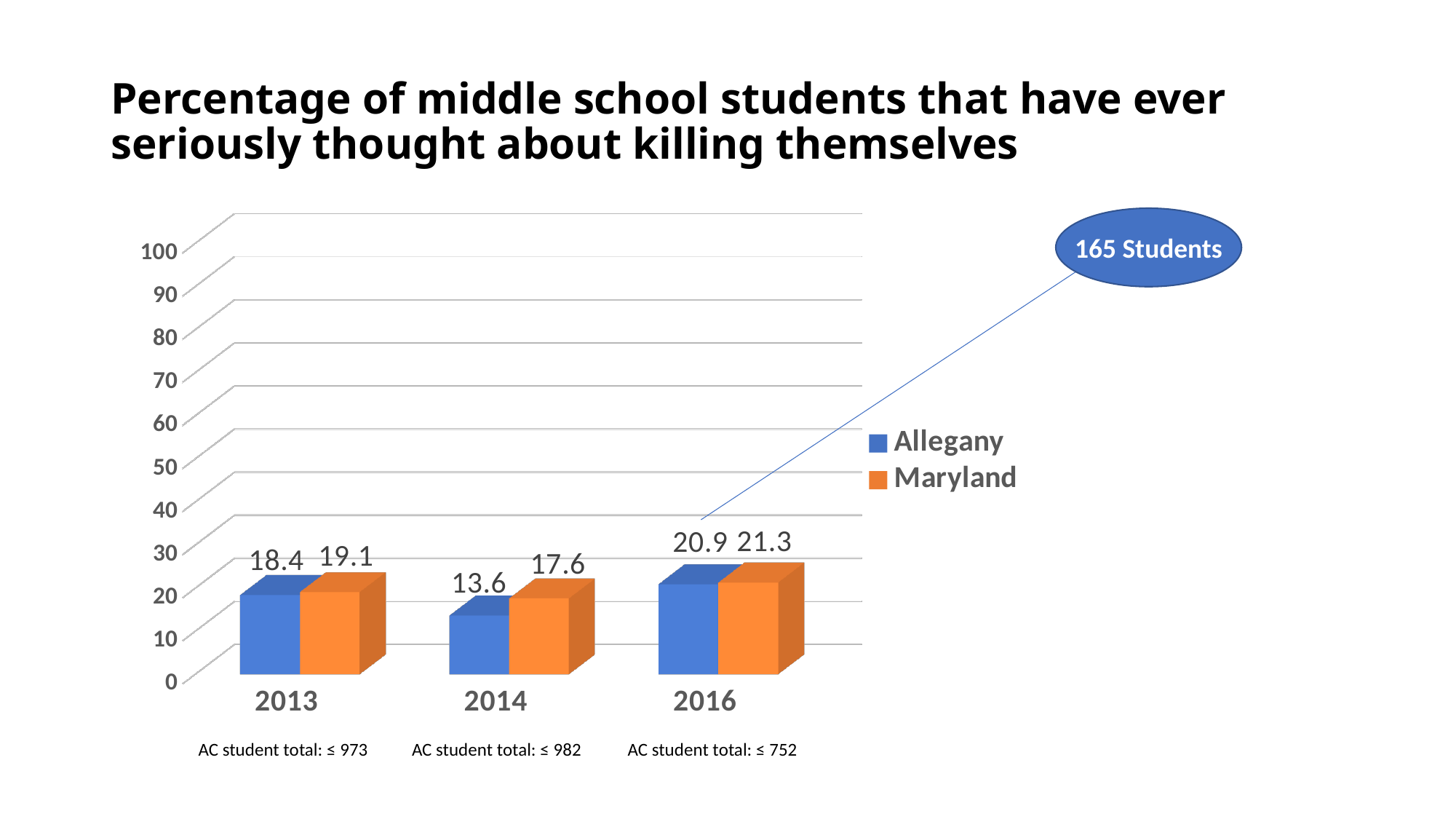
What is the difference between the Maryland and Allegany values in 2014? 4 In which year is the Allegany value lowest? 2014 How many series does the legend list? 2 In which year is the Maryland value highest? 2016 What is the value for Allegany in 2013? 18.4 What kind of chart is shown on the slide? Bar chart Which is larger in 2013, the Allegany value or the Maryland value? Maryland What does the callout bubble on the slide say? 165 Students What is the value for Maryland in 2016? 21.3 How many years are shown on the x axis? 3 What is the value for Maryland in 2014? 17.6 What is the value for Allegany in 2016? 20.9